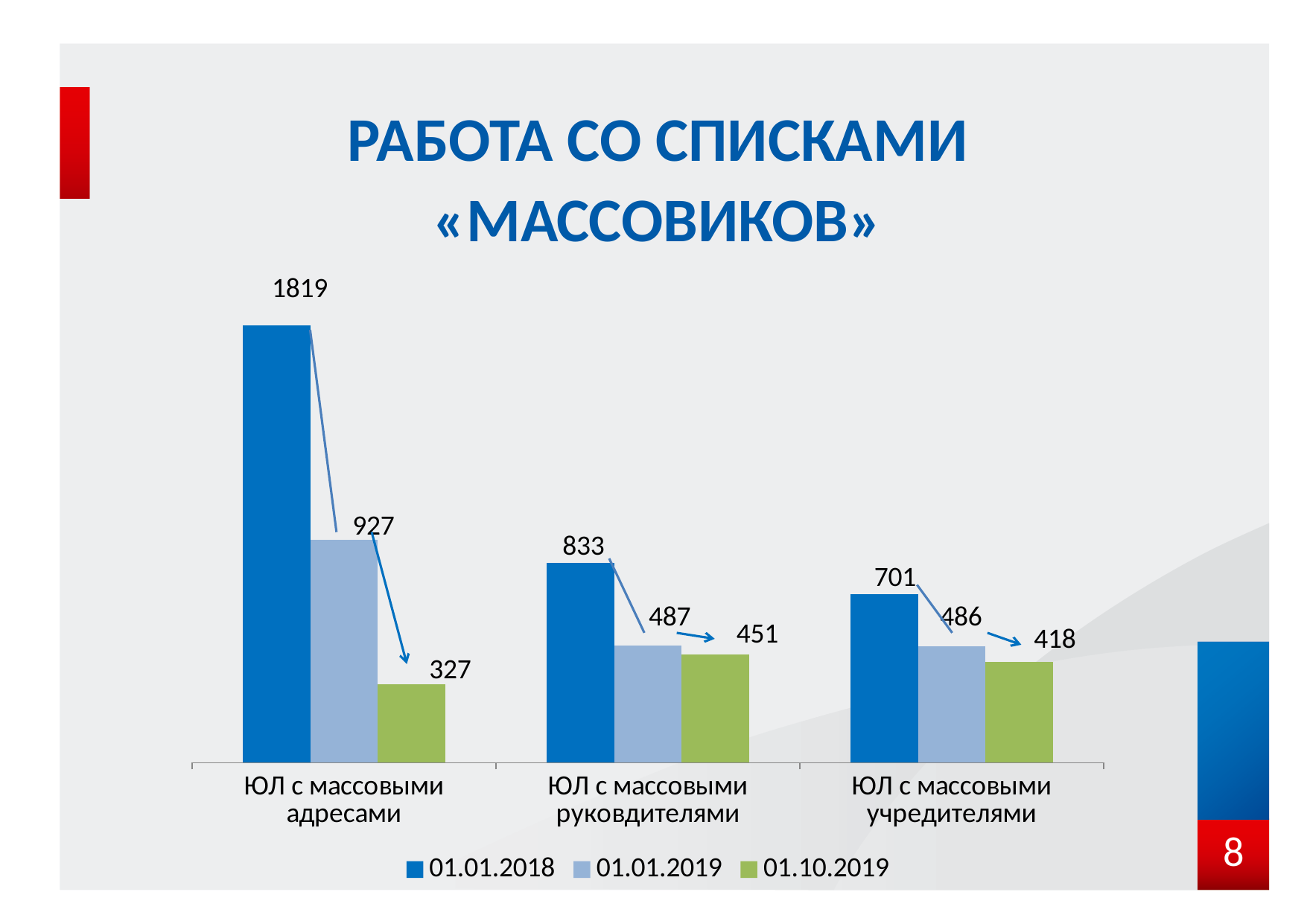
Which category has the highest value in the 01.01.2018 series? ЮЛ с массовыми адресами How many categories are shown on the x axis? 3 What is the value for 'ЮЛ с массовыми адресами' in the 01.01.2018 series? 1819 What is the difference between the 01.01.2018 and 01.10.2019 values for 'ЮЛ с массовыми адресами'? 1492 What is the value for 'ЮЛ с массовыми руковдителями' in the 01.10.2019 series? 451 What is the difference between the 01.01.2018 and 01.01.2019 values for 'ЮЛ с массовыми учредителями'? 215 What is the value for 'ЮЛ с массовыми учредителями' in the 01.01.2019 series? 486 How many series does the legend list? 3 What kind of chart is shown on the slide? bar chart Which is larger: the 01.01.2019 value for 'ЮЛ с массовыми руковдителями' or the 01.01.2019 value for 'ЮЛ с массовыми адресами'? ЮЛ с массовыми адресами Which category has the lowest value in the 01.10.2019 series? ЮЛ с массовыми адресами Within each category, do the values rise or fall from 01.01.2018 to 01.10.2019? fall